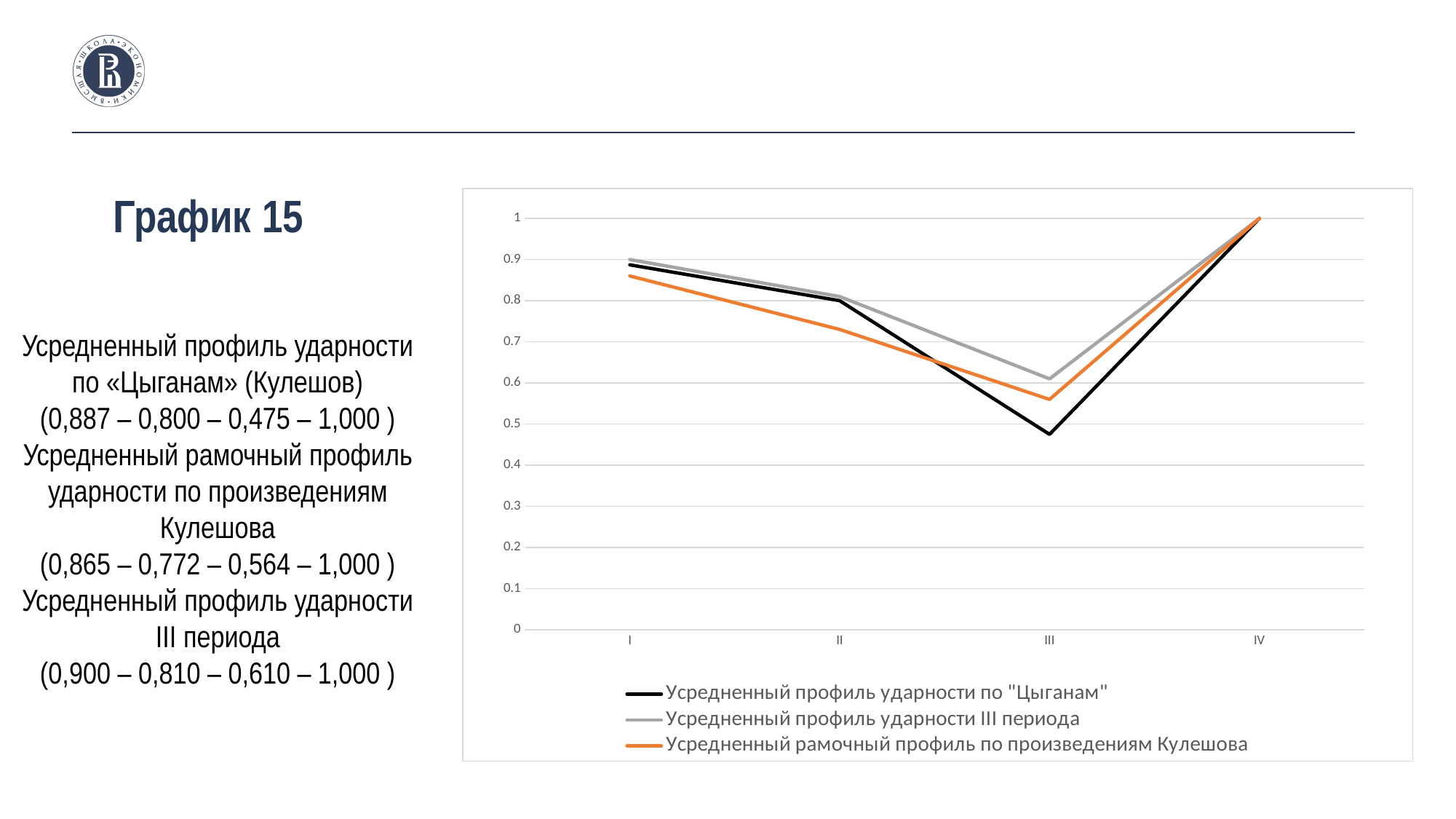
Do the values of the series "Усредненный профиль ударности по «Цыганам»" rise or fall from point I to point III? fall At point III, which series has the higher value: "Усредненный профиль ударности III периода" or "Усредненный профиль ударности по «Цыганам»"? Усредненный профиль ударности III периода What is the difference between the values of "Усредненный профиль ударности III периода" and "Усредненный профиль ударности по «Цыганам»" at point III? 0,135 What kind of chart is shown on the slide? line chart Which colour is used for the series "Усредненный рамочный профиль по произведениям Кулешова"? orange How many series does the chart legend list? 3 How many points are plotted along the x axis for each series? 4 What is the value of the series "Усредненный профиль ударности по «Цыганам»" at point III? 0,475 At which x-axis point does the series "Усредненный профиль ударности по «Цыганам»" reach its lowest value? III Is the value of "Усредненный рамочный профиль по произведениям Кулешова" at point III greater or less than 0.6? less What is the value of the series "Усредненный профиль ударности III периода" at point I? 0,900